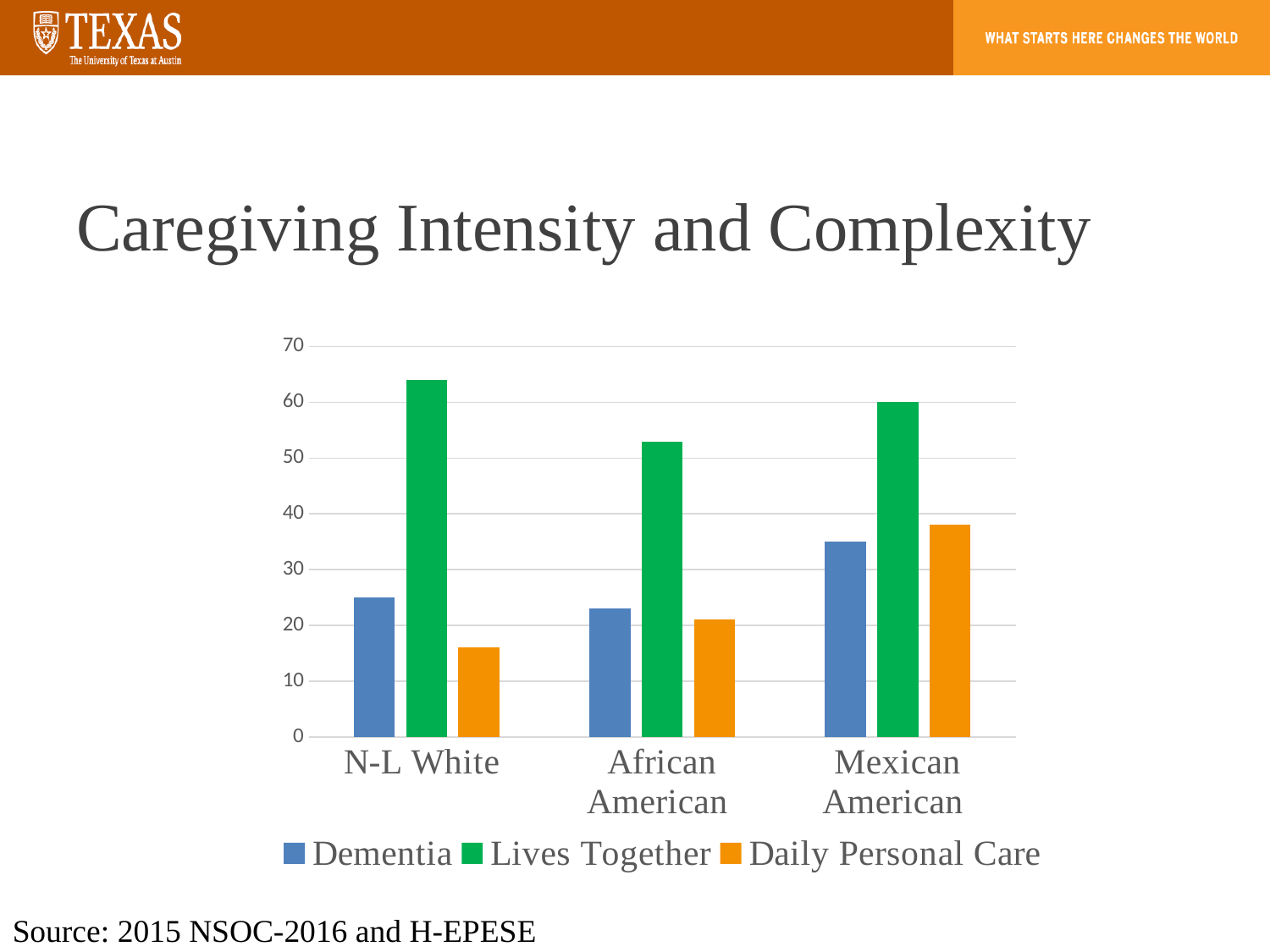
For N-L White, which is larger: the Dementia value or the Daily Personal Care value? Dementia Is the Lives Together value for African American greater or less than 40? greater What is the title of the slide containing the chart? Caregiving Intensity and Complexity How many categories are shown on the x axis? 3 What kind of chart is shown on the slide? bar chart Which category has the highest value for Daily Personal Care? Mexican American How many series does the legend list? 3 Which category has the highest value for Lives Together? N-L White Which category has the highest value for Dementia? Mexican American Is the Daily Personal Care value for N-L White greater or less than 20? less Which category has the lowest value for Daily Personal Care? N-L White Is the Dementia value for N-L White greater or less than 20? greater